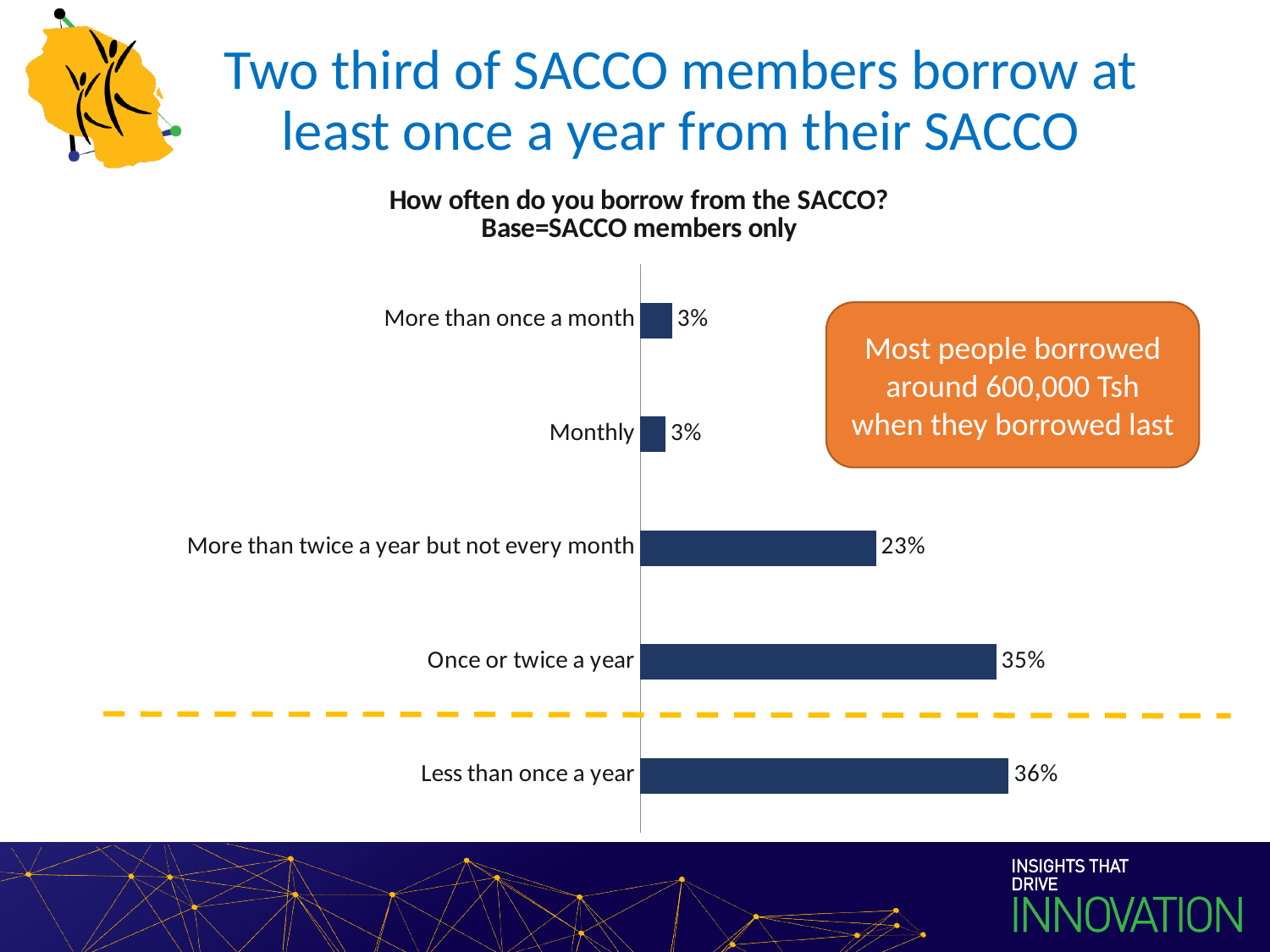
How many borrowing frequency categories are shown in the chart? 5 What is the value for 'More than twice a year but not every month'? 23% What is the value for 'More than once a month'? 3% What percentage of SACCO members borrow less than once a year? 36% What is the difference between 'Once or twice a year' and 'More than twice a year but not every month'? 12% Which is larger: the value for 'Once or twice a year' or the value for 'More than twice a year but not every month'? Once or twice a year What is the difference between 'Less than once a year' and 'Once or twice a year'? 1% What question does the chart title say was asked? How often do you borrow from the SACCO? Which borrowing frequency has the highest percentage? Less than once a year What percentage of SACCO members borrow monthly? 3% What type of chart is shown on the slide? Bar chart What percentage of SACCO members borrow once or twice a year? 35%